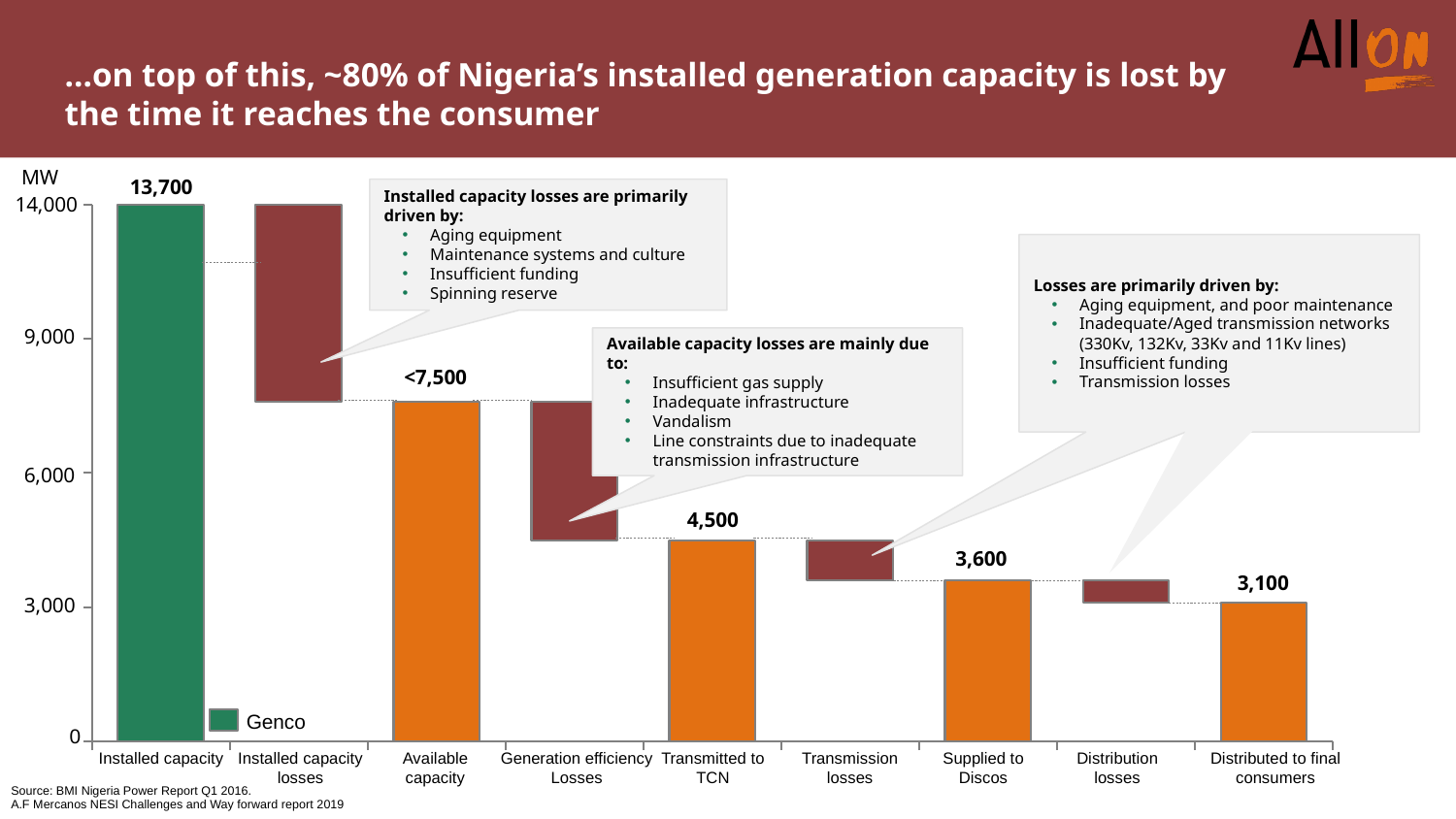
What kind of chart is shown on the slide? bar chart Which is larger, Transmitted to TCN or Distributed to final consumers? Transmitted to TCN How many categories are shown on the x axis? 9 What is the difference between Transmitted to TCN and Supplied to Discos? 900 What value is labelled on the Available capacity bar? <7,500 What is the value for Installed capacity? 13,700 What is the value for Distributed to final consumers? 3,100 What is the value for Transmitted to TCN? 4,500 What is the value for Supplied to Discos? 3,600 Which category has the highest value? Installed capacity What is the difference between Supplied to Discos and Distributed to final consumers? 500 What unit is shown on the y axis? MW